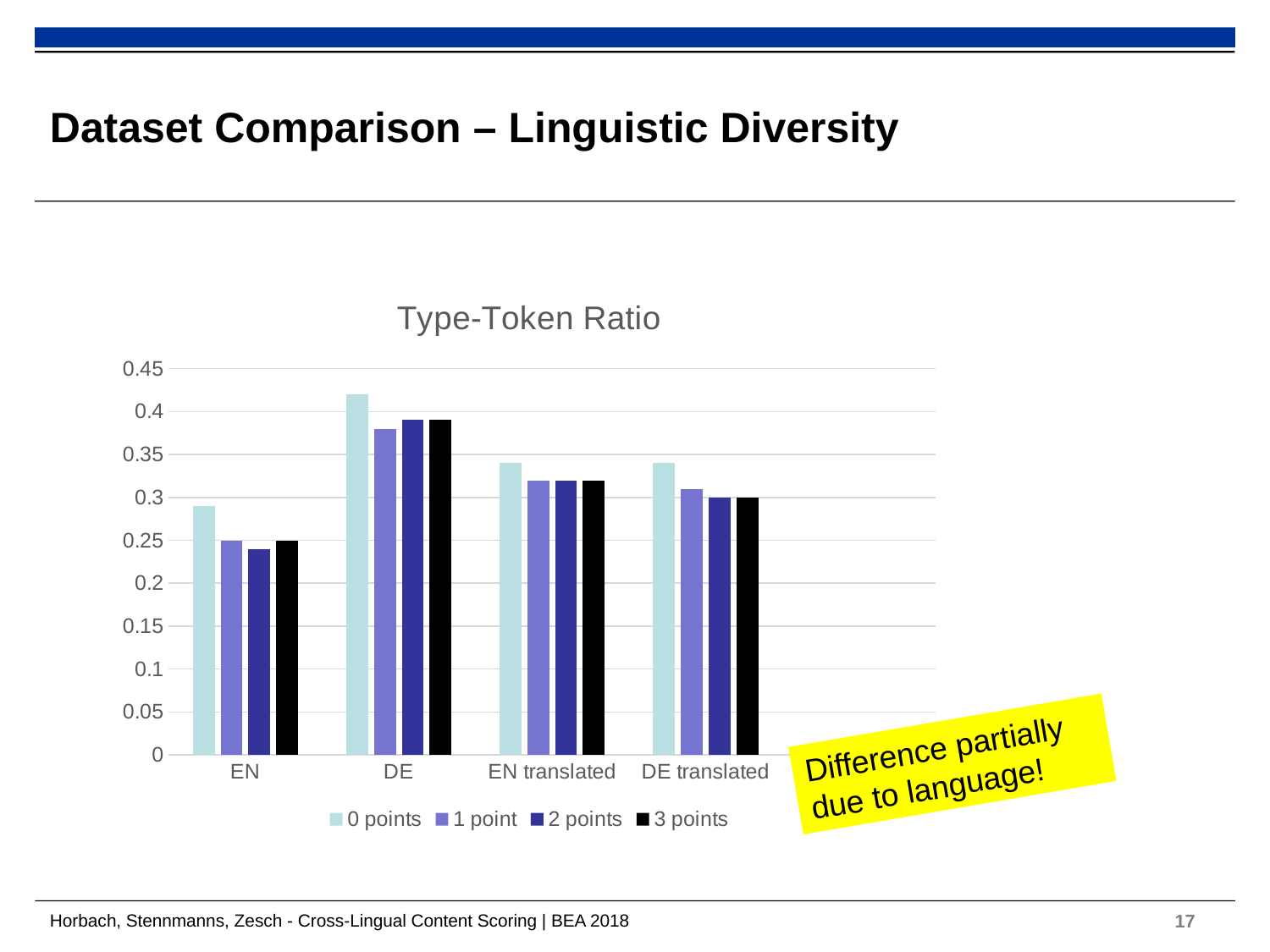
What type of chart is shown on the slide? bar chart How many categories are shown on the x axis? 4 Is the 0 points value for EN translated greater or less than 0.35? less Is the 0 points value for DE greater or less than 0.4? greater Is the 2 points value for EN greater or less than 0.3? less Which category has the highest value for the 0 points series? DE How many series does the legend list? 4 What does the yellow callout on the slide say? Difference partially due to language! Which category has the lowest value for the 0 points series? EN What is the title of the chart? Type-Token Ratio Which is larger: the 0 points value for DE or the 0 points value for EN? DE Which is larger: the 1 point value for DE or the 1 point value for EN translated? DE